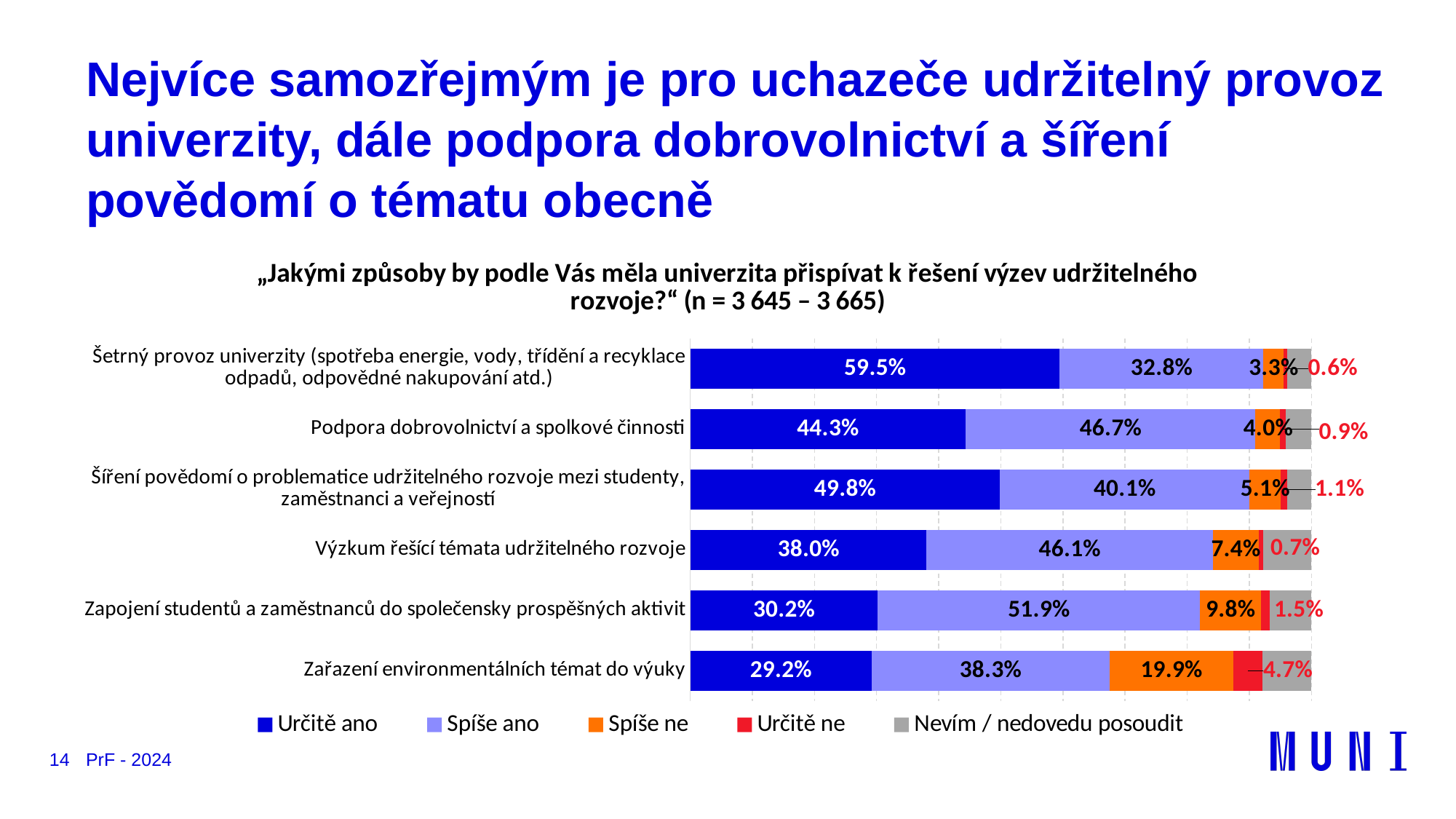
What is the difference between the 'Určitě ano' values for 'Šetrný provoz univerzity' and 'Výzkum řešící témata udržitelného rozvoje'? 21.5% What is the 'Určitě ano' value for 'Šetrný provoz univerzity (spotřeba energie, vody, třídění a recyklace odpadů, odpovědné nakupování atd.)'? 59.5% How many categories (rows) are plotted in the chart? 6 What is the 'Určitě ne' value for 'Zapojení studentů a zaměstnanců do společensky prospěšných aktivit'? 1.5% Which category has the lowest 'Určitě ano' value? Zařazení environmentálních témat do výuky What is the 'Spíše ne' value for 'Zařazení environmentálních témat do výuky'? 19.9% Which series is shown in orange in the legend? Spíše ne How many series does the legend list? 5 What is the 'Spíše ano' value for 'Podpora dobrovolnictví a spolkové činnosti'? 46.7% What kind of chart is shown on the slide? stacked bar chart Which is larger: the 'Spíše ano' value for 'Zapojení studentů a zaměstnanců do společensky prospěšných aktivit' or for 'Výzkum řešící témata udržitelného rozvoje'? Zapojení studentů a zaměstnanců do společensky prospěšných aktivit Which category has the highest 'Určitě ano' value? Šetrný provoz univerzity (spotřeba energie, vody, třídění a recyklace odpadů, odpovědné nakupování atd.)